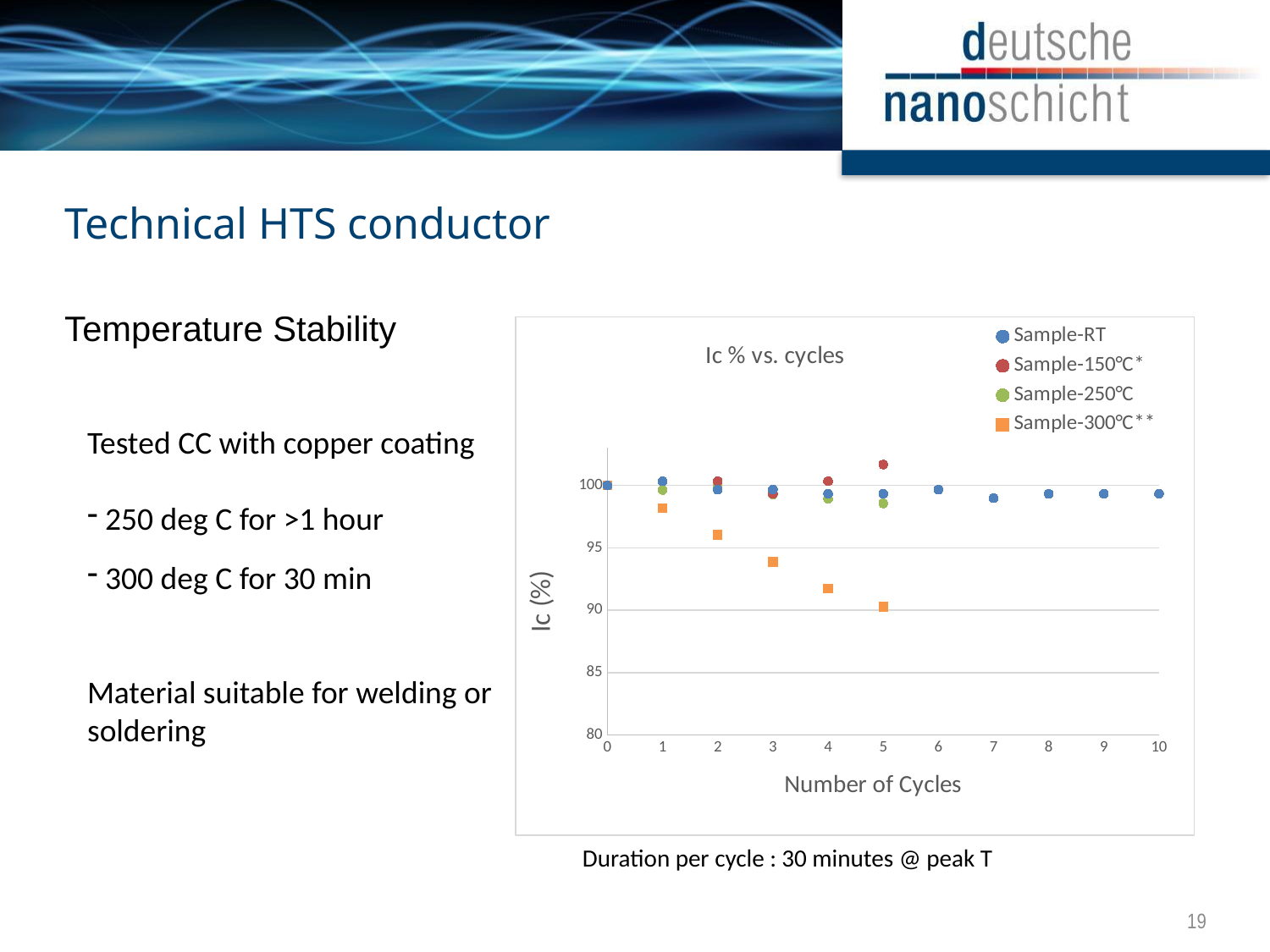
What is the label of the x axis of the chart? Number of Cycles How many data points are plotted for the Sample-RT series? 11 Which series has the lowest Ic (%) value at cycle 5? Sample-300℃** Is the Ic (%) value for Sample-300℃** at cycle 4 greater or less than 90? greater Is the Ic (%) value for Sample-300℃** at cycle 5 greater or less than 95? less What is the title of the chart? Ic % vs. cycles Do the Ic (%) values for Sample-300℃** rise or fall as the number of cycles increases? fall What kind of chart is shown on the slide? scatter chart Which series has the highest Ic (%) value at cycle 5? Sample-150℃* At cycle 3, which series has the larger Ic (%) value, Sample-RT or Sample-300℃**? Sample-RT How many series does the chart legend list? 4 Is the Ic (%) value for Sample-300℃** at cycle 2 greater or less than 95? greater